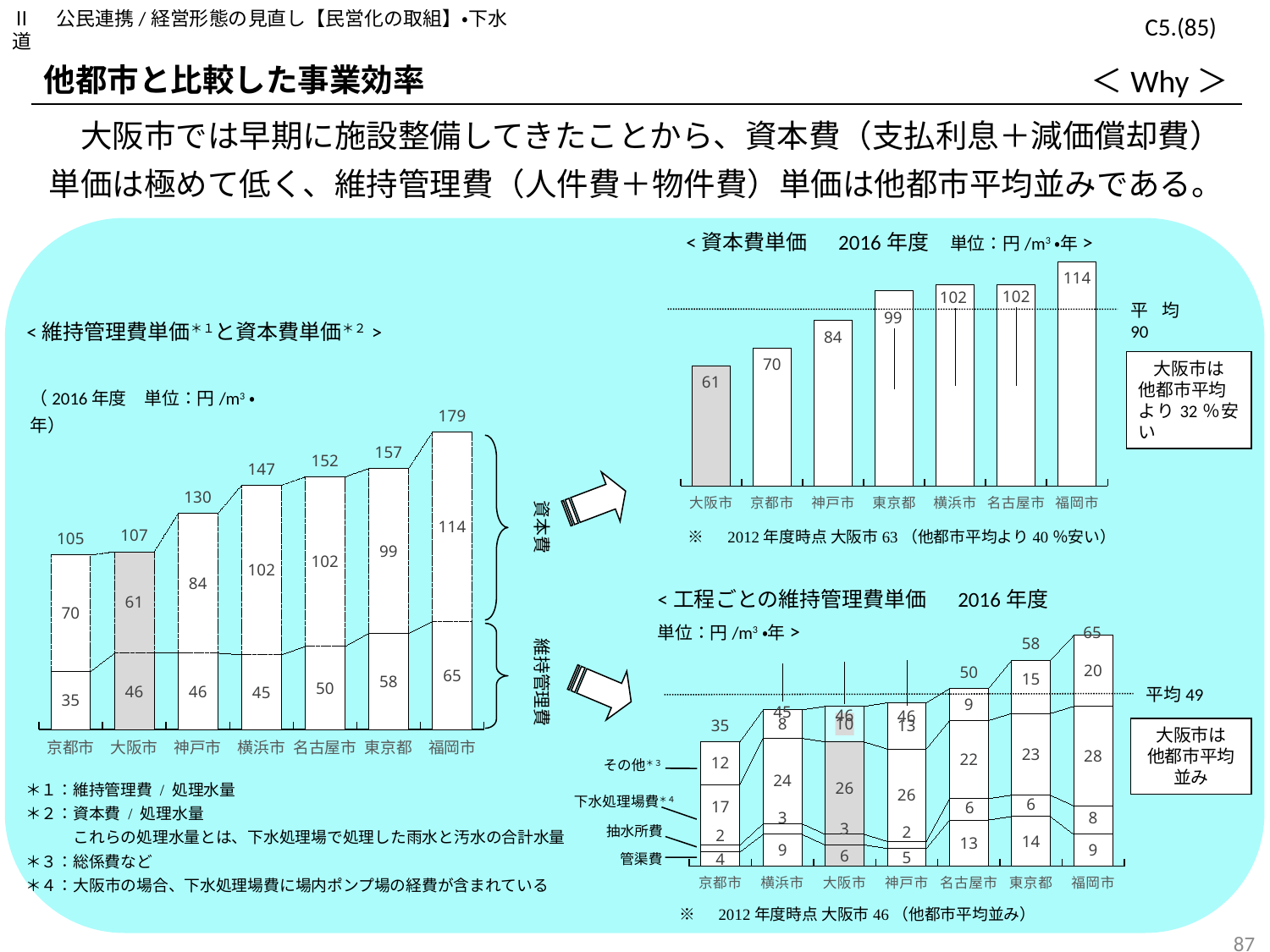
In the top-right chart titled 資本費単価 2016年度, what is the difference between the values for 福岡市 and 大阪市? 53 What kind of chart is the left chart titled 維持管理費単価と資本費単価? Stacked bar chart In the top-right chart titled 資本費単価 2016年度, what value is shown for the 平均 (average) line? 90 In the bottom-right chart titled 工程ごとの維持管理費単価 2016年度, what is the 下水処理場費 value for 福岡市? 28 In the top-right chart titled 資本費単価 2016年度, what is the value for 福岡市? 114 In the left chart titled 維持管理費単価と資本費単価, do the bar totals rise or fall from 京都市 on the left to 福岡市 on the right? Rise In the top-right chart titled 資本費単価 2016年度, which city has the lowest value? 大阪市 In the bottom-right chart titled 工程ごとの維持管理費単価 2016年度, which has the larger total, 東京都 or 名古屋市? 東京都 In the bottom-right chart titled 工程ごとの維持管理費単価 2016年度, which city has the highest total? 福岡市 In the left chart titled 維持管理費単価と資本費単価, what is the 維持管理費 (lower segment) value for 京都市? 35 In the left chart titled 維持管理費単価と資本費単価, how many cities are shown on the x axis? 7 In the left chart titled 維持管理費単価と資本費単価, what is the total value of the bar for 福岡市? 179